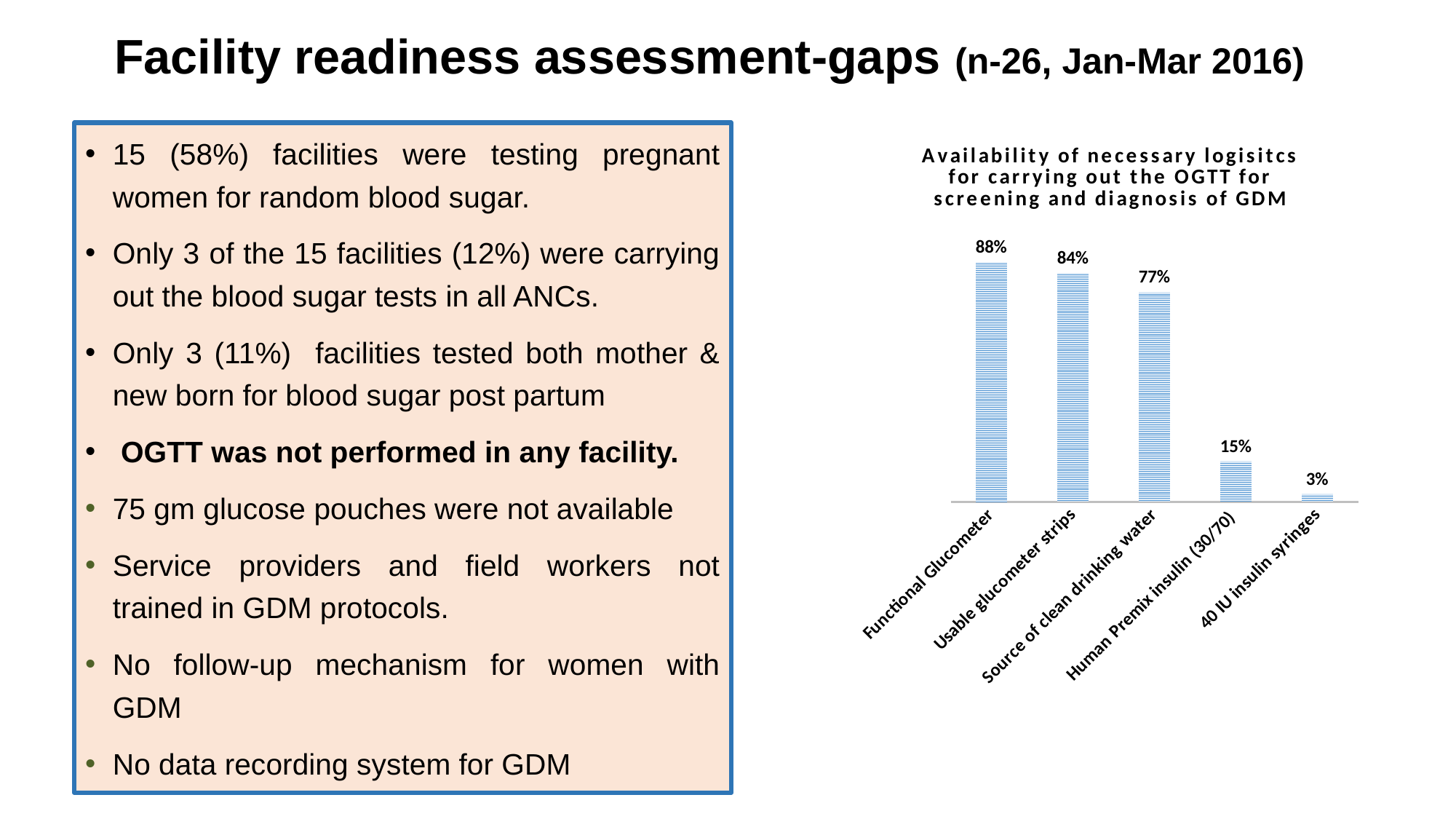
Do the values rise or fall from left to right across the categories? Fall What is the value for Human Premix insulin (30/70)? 15% How many categories are shown in the chart? 5 Which is larger, the value for Human Premix insulin (30/70) or the value for 40 IU insulin syringes? Human Premix insulin (30/70) Which category has the lowest value? 40 IU insulin syringes What is the value for Source of clean drinking water? 77% What is the value for 40 IU insulin syringes? 3% What is the value for Functional Glucometer? 88% Which category has the highest value? Functional Glucometer What kind of chart is shown on the slide? Bar chart What is the value for Usable glucometer strips? 84% What is the difference between the values for Functional Glucometer and Source of clean drinking water? 11%